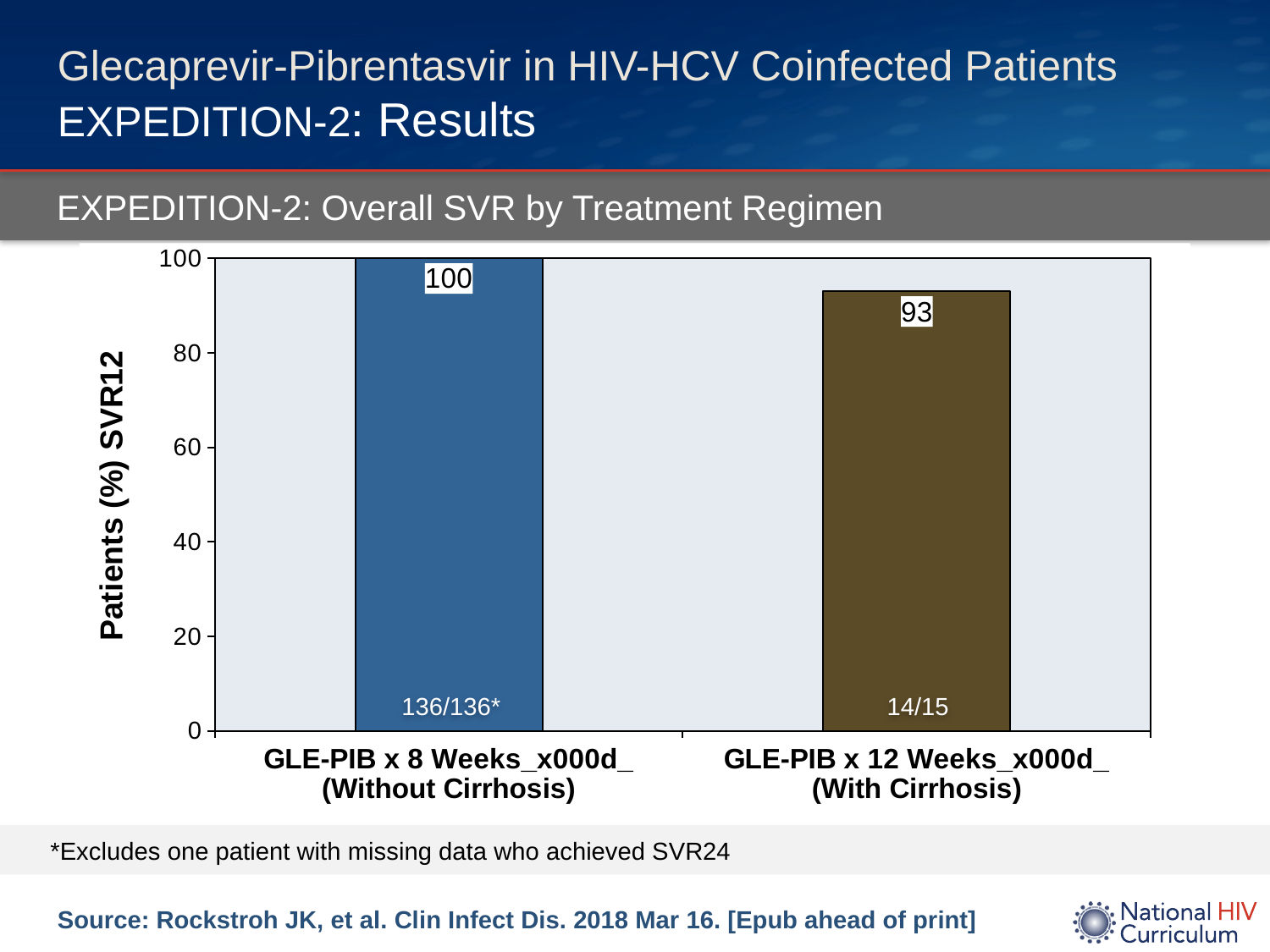
What fraction of patients is shown inside the bar for GLE-PIB x 8 Weeks (Without Cirrhosis)? 136/136* Which treatment regimen has the highest SVR12 rate? GLE-PIB x 8 Weeks (Without Cirrhosis) What is the SVR12 rate for GLE-PIB x 12 Weeks (With Cirrhosis)? 93 What is the difference in SVR12 rate between the 8-week and 12-week regimens? 7 Which treatment regimen has the lowest SVR12 rate? GLE-PIB x 12 Weeks (With Cirrhosis) What kind of chart is shown on the slide? Bar chart What is the label of the y-axis? Patients (%) SVR12 Which has a higher SVR12 rate: GLE-PIB x 8 Weeks (Without Cirrhosis) or GLE-PIB x 12 Weeks (With Cirrhosis)? GLE-PIB x 8 Weeks (Without Cirrhosis) What is the SVR12 rate for GLE-PIB x 8 Weeks (Without Cirrhosis)? 100 What fraction of patients is shown inside the bar for GLE-PIB x 12 Weeks (With Cirrhosis)? 14/15 Is the value for GLE-PIB x 12 Weeks (With Cirrhosis) greater or less than 80? greater How many treatment regimens are shown in the chart? 2